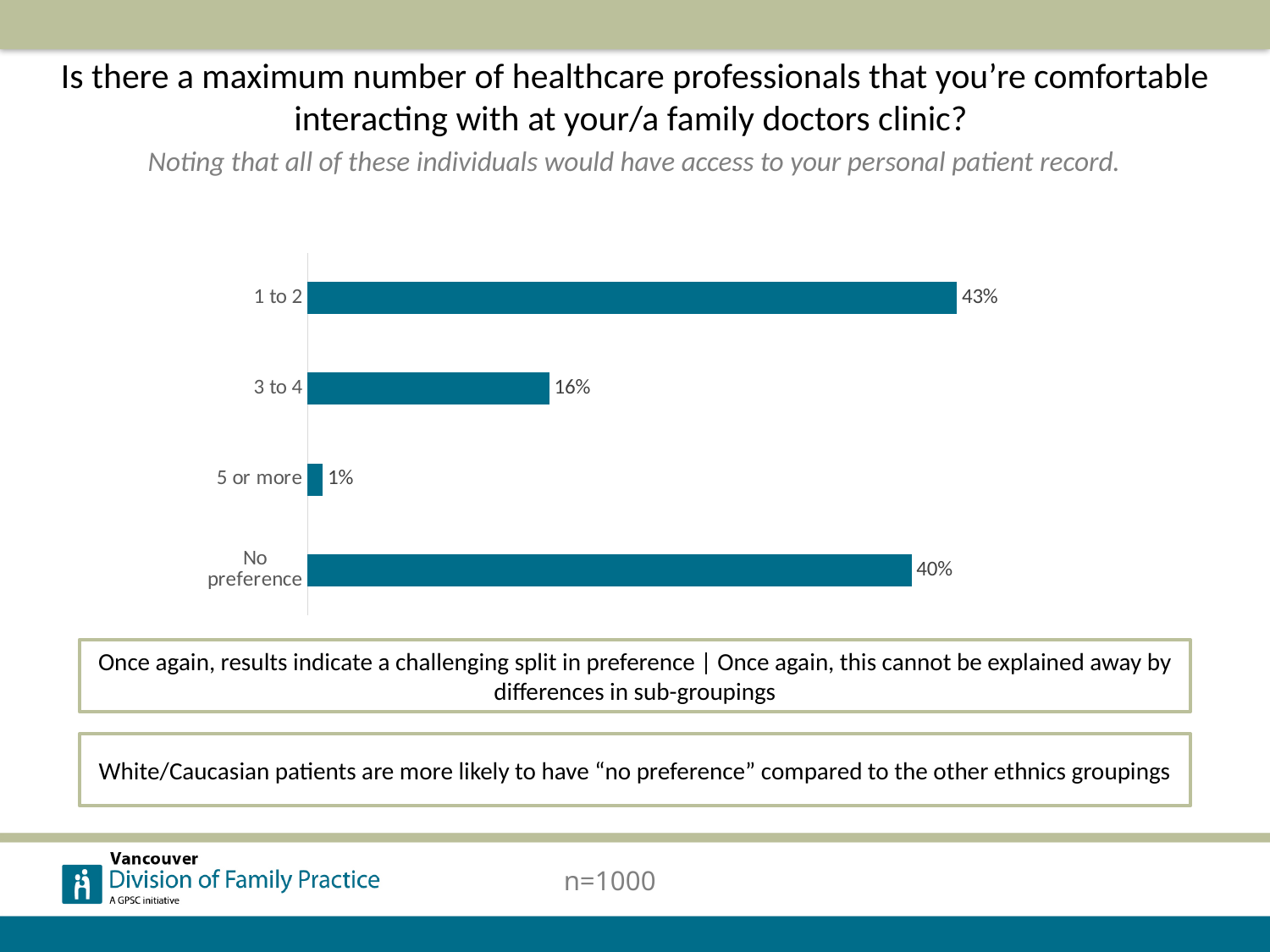
What percentage of respondents said No preference? 40% What percentage of respondents said 3 to 4? 16% How many categories are shown in the chart? 4 What kind of chart is shown on the slide? Bar chart What is the difference in percentage points between 1 to 2 and No preference? 3 Which is larger, the value for 3 to 4 or the value for No preference? No preference What is the difference in percentage points between 3 to 4 and 5 or more? 15 What percentage of respondents said 1 to 2? 43% What percentage of respondents said 5 or more? 1% Which category has the highest percentage? 1 to 2 What sample size is noted at the bottom of the slide? n=1000 Which category has the lowest percentage? 5 or more